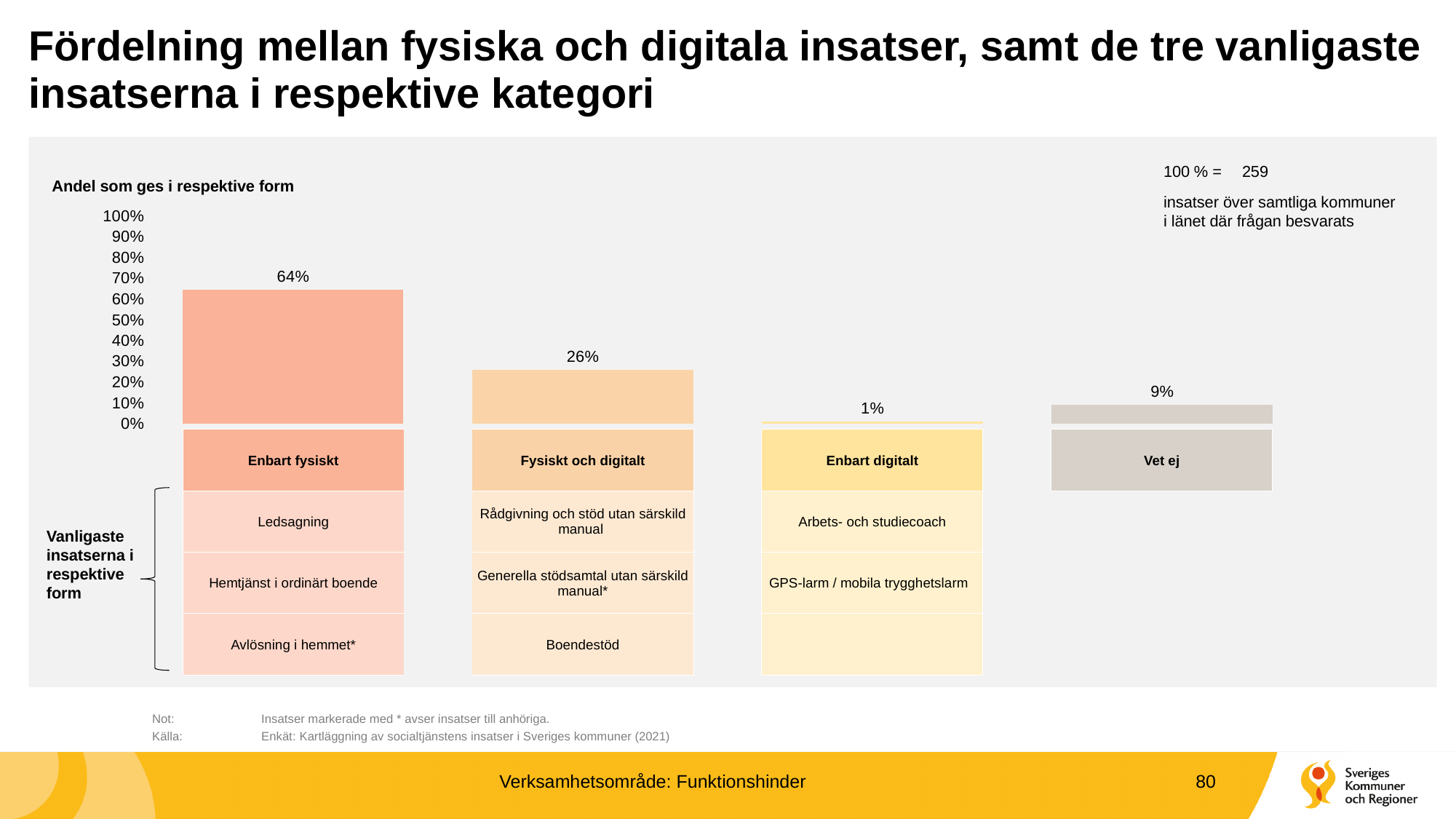
What is the value for Fysiskt och digitalt? 26% What is the value for Enbart digitalt? 1% Which category has the lowest value? Enbart digitalt What is the value for Vet ej? 9% What kind of chart is this? bar chart How many categories are shown in the chart? 4 Which is larger, the value for Vet ej or the value for Enbart digitalt? Vet ej What is the value for Enbart fysiskt? 64% Which category has the highest value? Enbart fysiskt What is the difference between the values for Enbart fysiskt and Fysiskt och digitalt? 38% What is the title of the chart? Andel som ges i respektive form Is the value for Enbart fysiskt greater or less than 50%? greater